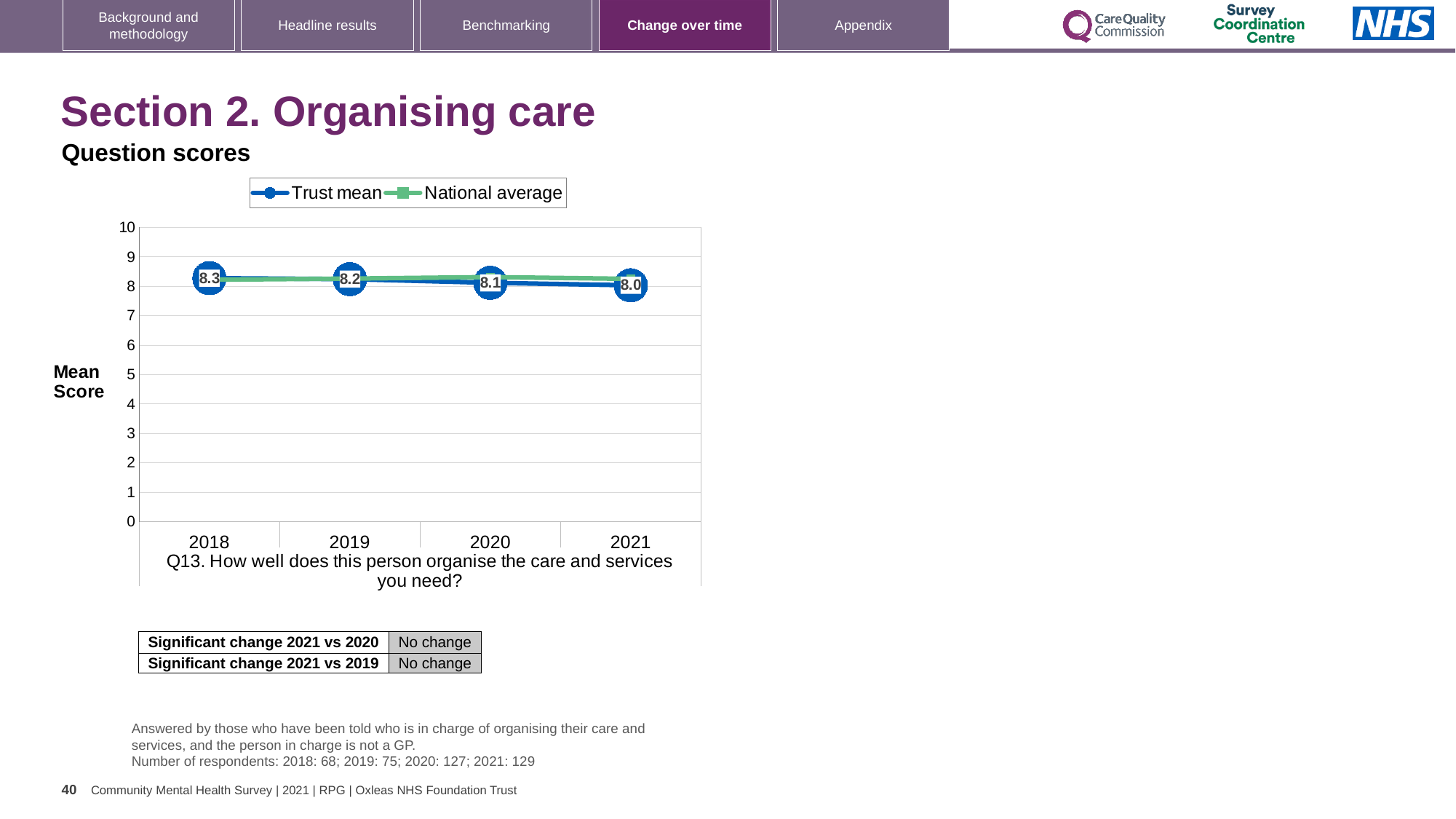
In which year is the Trust mean highest? 2018 How many series does the legend list? 2 Is the Trust mean for 2019 greater or less than 7? greater What is the Trust mean for 2018? 8.3 What is the Trust mean for 2021? 8.0 What is the difference between the Trust mean in 2018 and in 2021? 0.3 What kind of chart is shown? line chart What is the Trust mean for 2020? 8.1 Which is larger, the Trust mean in 2019 or in 2021? 2019 How many years are plotted on the x axis? 4 Does the Trust mean rise or fall from 2018 to 2021? fall In which year is the Trust mean lowest? 2021